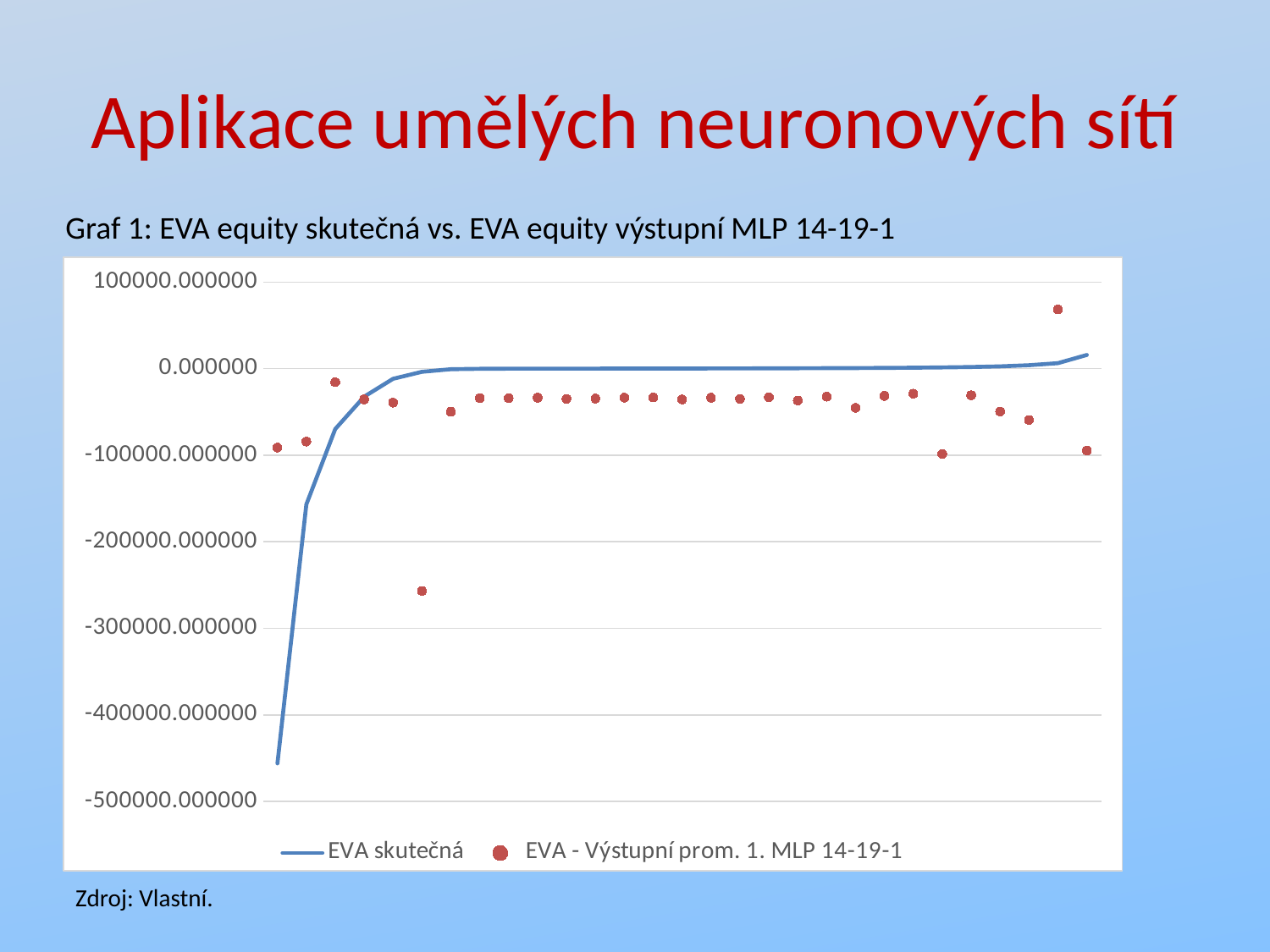
What colour is the EVA skutečná line? blue Which series reaches the lowest value on the chart? EVA skutečná How many series does the legend list? 2 Which series reaches the highest value on the chart? EVA - Výstupní prom. 1. MLP 14-19-1 What kind of chart is shown on the slide? line chart Is the lowest point of the EVA - Výstupní prom. 1. MLP 14-19-1 series greater or less than -200000.000000? less Is the last value of the EVA skutečná line greater or less than 0.000000? greater Does the EVA skutečná line rise or fall along the x axis? rise Is the highest point of the EVA - Výstupní prom. 1. MLP 14-19-1 series greater or less than 0.000000? greater What is the title of the chart? Graf 1: EVA equity skutečná vs. EVA equity výstupní MLP 14-19-1